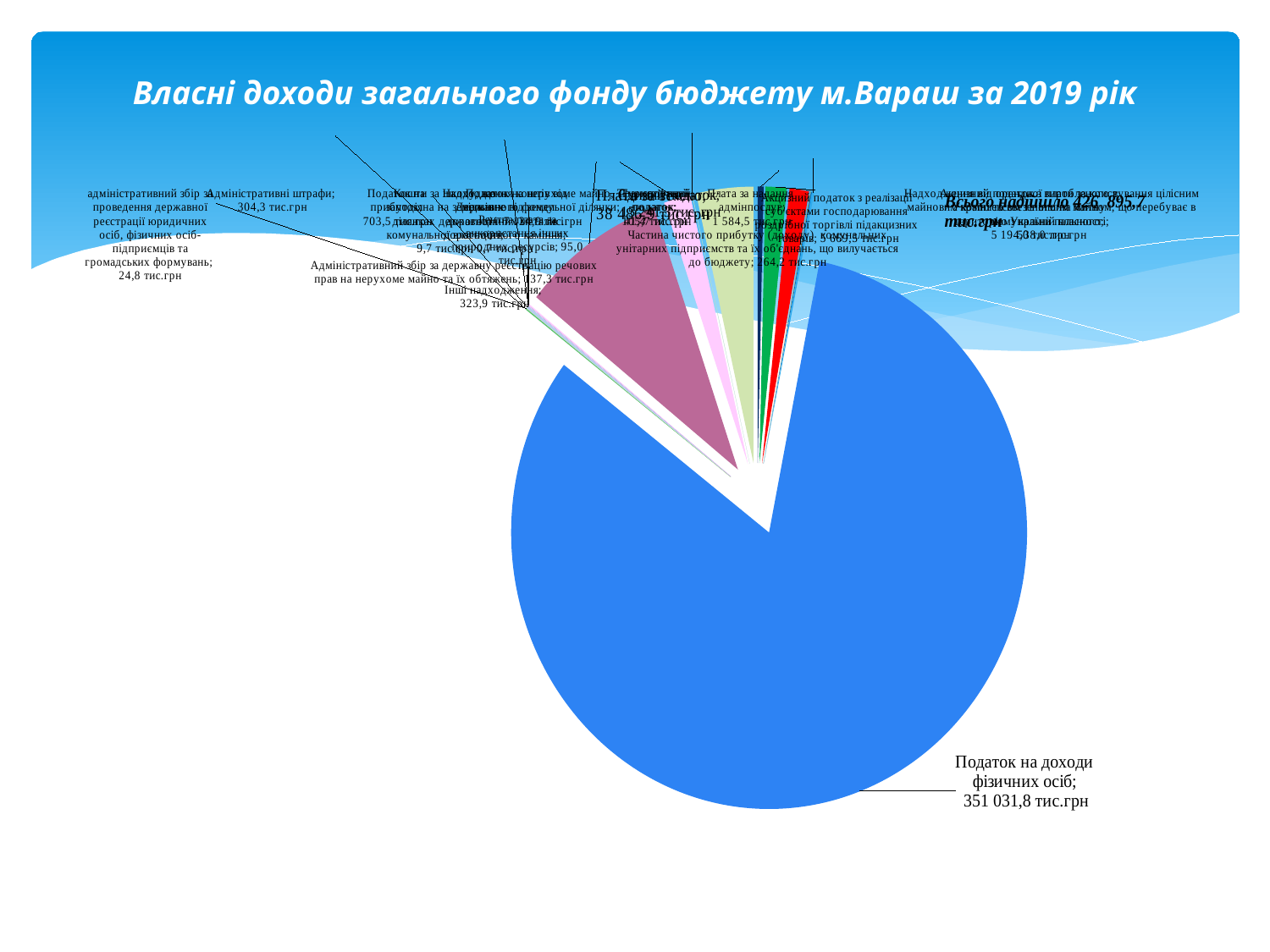
What is the title of the chart? Власні доходи загального фонду бюджету м.Вараш за 2019 рік What kind of chart is shown on the slide? pie chart What is the value for Частина чистого прибутку (доходу) комунальних унітарних підприємств та їх об'єднань, що вилучається до бюджету? 264,2 тис.грн Which category has the largest slice of the pie? Податок на доходи фізичних осіб What is the value for Інші надходження? 323,9 тис.грн Which is larger: Адміністративний збір за державну реєстрацію речових прав на нерухоме майно та їх обтяжень or адміністративний збір за проведення державної реєстрації юридичних осіб, фізичних осіб-підприємців та громадських формувань? Адміністративний збір за державну реєстрацію речових прав на нерухоме майно та їх обтяжень What is the value for Податок на доходи фізичних осіб? 351 031,8 тис.грн What is the difference between Інші надходження and Адміністративні штрафи? 19,6 тис.грн Which is larger: Адміністративні штрафи or Інші надходження? Інші надходження What is the value for Адміністративні штрафи? 304,3 тис.грн What is the value for адміністративний збір за проведення державної реєстрації юридичних осіб, фізичних осіб-підприємців та громадських формувань? 24,8 тис.грн What is the value for Адміністративний збір за державну реєстрацію речових прав на нерухоме майно та їх обтяжень? 137,3 тис.грн